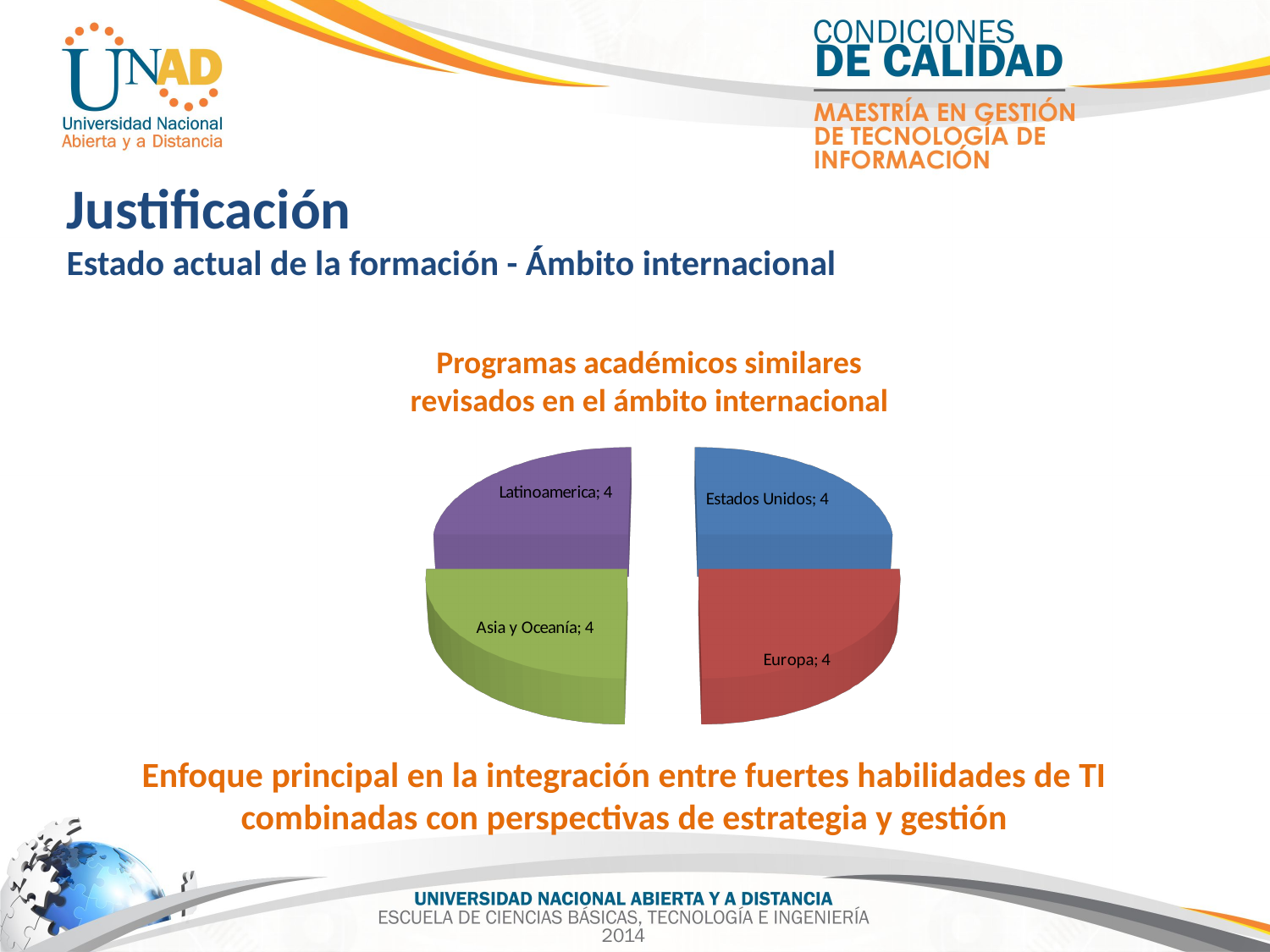
What is the total of all the slice values in the pie chart? 16 What share of the pie does the Europa slice represent? 25% What is the value shown for Europa? 4 How many slices does the pie chart have? 4 What is the value shown for Latinoamerica? 4 What is the value shown for Estados Unidos? 4 What is the title of the pie chart? Programas académicos similares revisados en el ámbito internacional What kind of chart is shown on the slide? Pie chart Which colour is the Asia y Oceanía slice? Green What is the value shown for Asia y Oceanía? 4 What is the difference between the values for Europa and Latinoamerica? 0